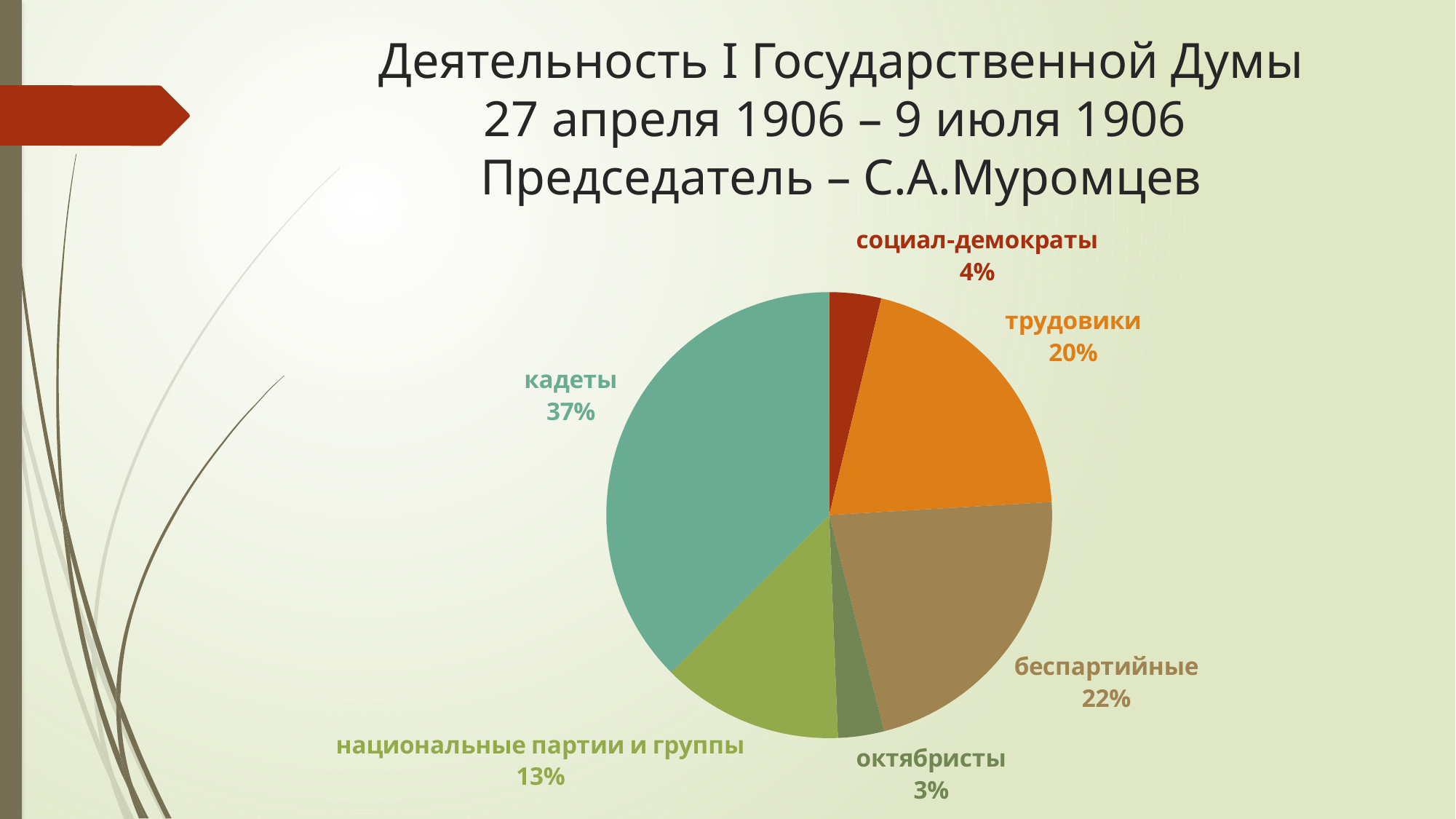
Which is larger, the share of трудовики or the share of беспартийные? беспартийные What is the difference between the shares of кадеты and беспартийные? 15% How many categories are shown in the pie chart? 6 What is the value shown for социал-демократы? 4% Which category has the largest slice of the pie? кадеты What is the value shown for трудовики? 20% What colour is the slice for кадеты? teal What is the value shown for беспартийные? 22% What share of the pie does кадеты hold? 37% What kind of chart is shown on the slide? pie chart Which category has the smallest slice of the pie? октябристы What is the value shown for национальные партии и группы? 13%